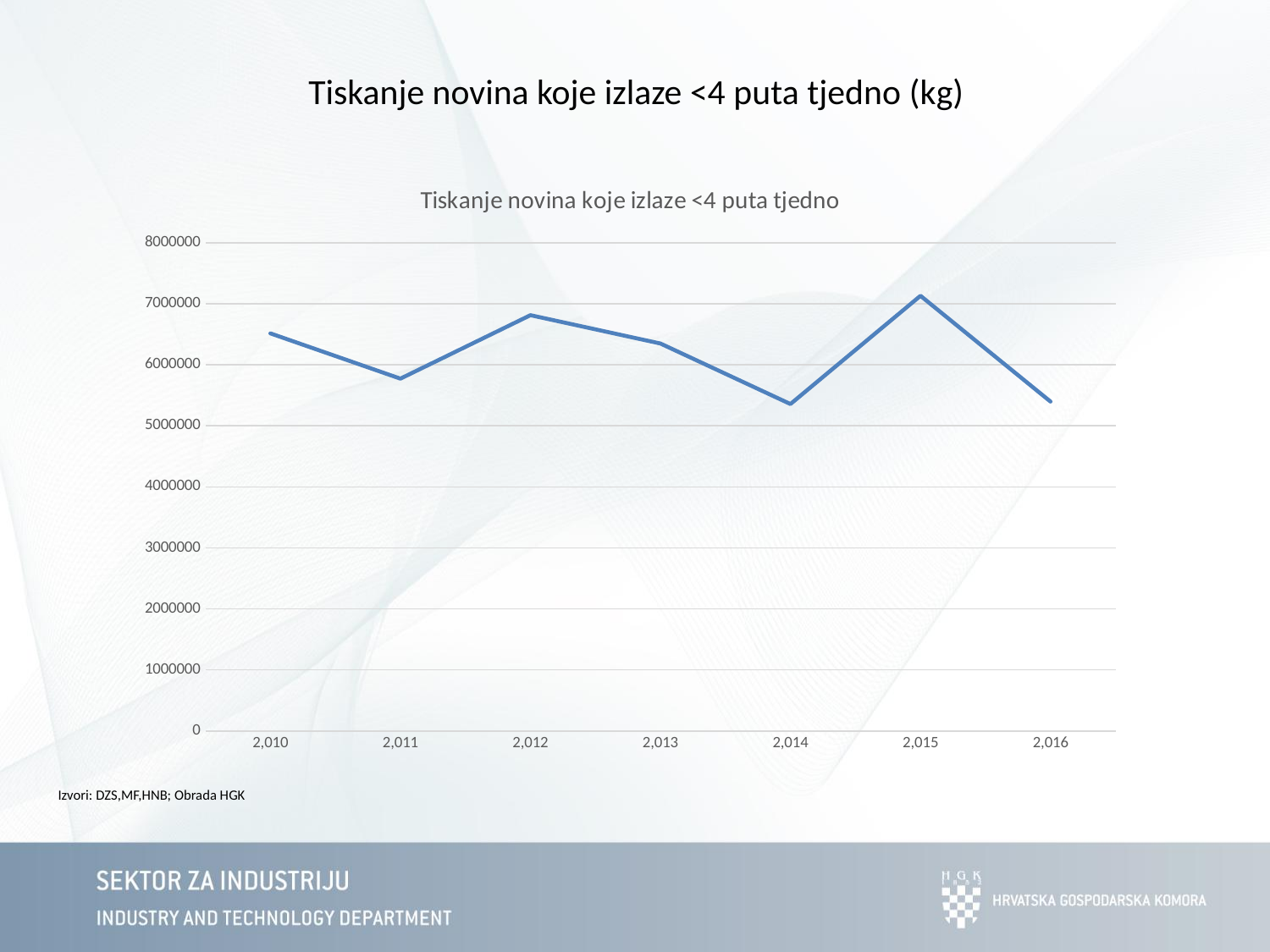
What kind of chart is shown on the slide? line chart Is the value for 2011 greater or less than 6000000? less Is the value for 2012 greater or less than 7000000? less Which year has the larger value, 2015 or 2016? 2015 Does the value rise or fall from 2014 to 2015? rise How many years are plotted on the x axis of the chart? 7 Is the value for 2010 greater or less than 6000000? greater Which year has the larger value, 2011 or 2012? 2012 What is the title shown above the chart area? Tiskanje novina koje izlaze <4 puta tjedno Does the value rise or fall from 2015 to 2016? fall Which year has the highest value in the chart? 2015